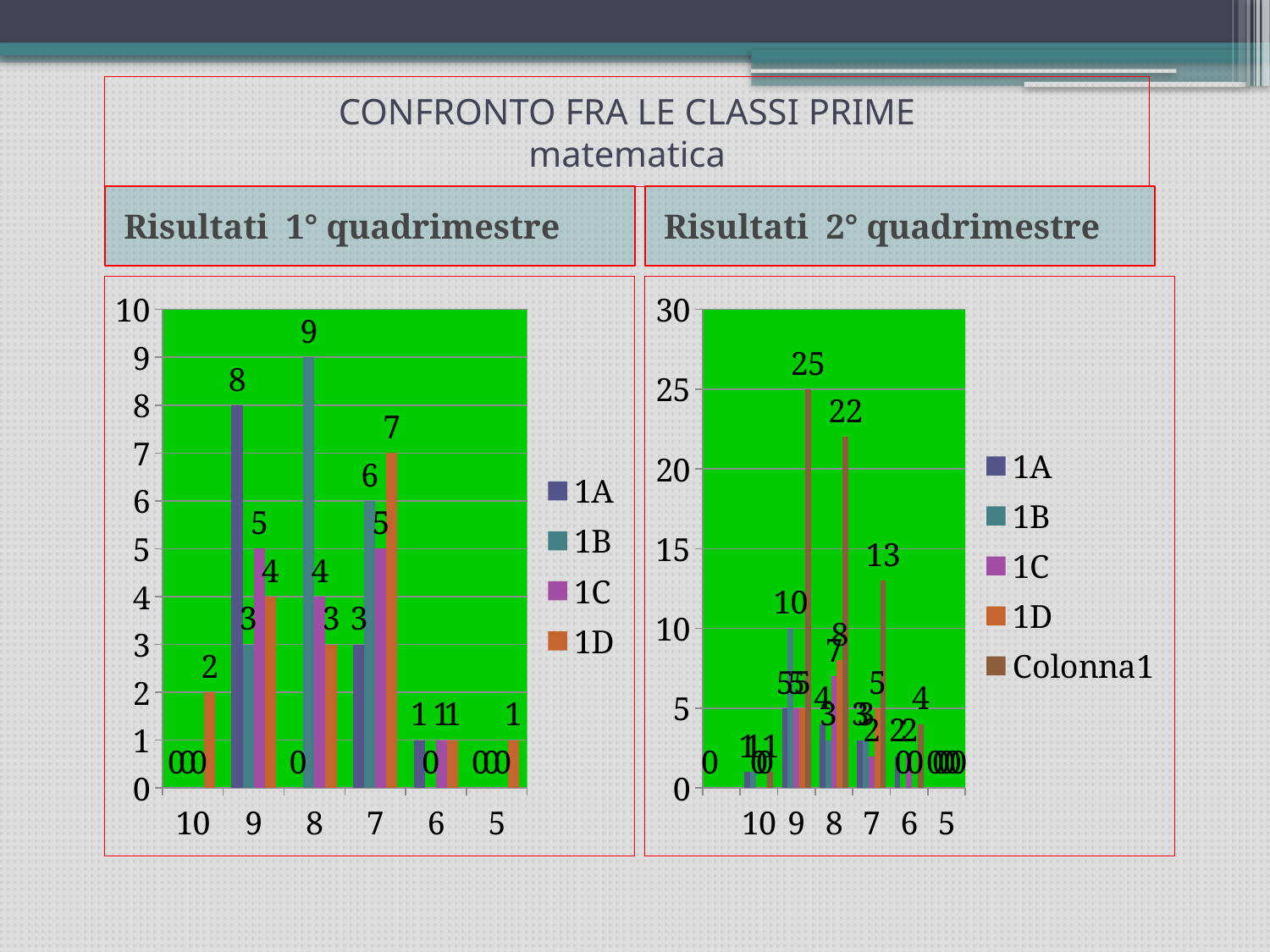
In the left chart ('Risultati 1° quadrimestre'), what is the value for 1A at grade 9? 8 In the left chart ('Risultati 1° quadrimestre'), which series has the highest bar at grade 8? 1B How many series does the legend of the left chart ('Risultati 1° quadrimestre') list? 4 In the left chart ('Risultati 1° quadrimestre'), at grade 7, which is larger: 1D or 1B? 1D How many grade categories are shown on the x axis of the right chart ('Risultati 2° quadrimestre')? 6 What kind of chart is the 'Risultati 1° quadrimestre' chart on the left? bar chart In the left chart ('Risultati 1° quadrimestre'), what is the value for 1B at grade 8? 9 In the left chart ('Risultati 1° quadrimestre'), what is the value for 1D at grade 10? 2 In the left chart ('Risultati 1° quadrimestre'), what is the value for 1D at grade 7? 7 In the left chart ('Risultati 1° quadrimestre'), what is the difference between the values for 1A and 1B at grade 9? 5 In the right chart ('Risultati 2° quadrimestre'), what is the value for Colonna1 at grade 8? 22 How many series does the legend of the right chart ('Risultati 2° quadrimestre') list? 5